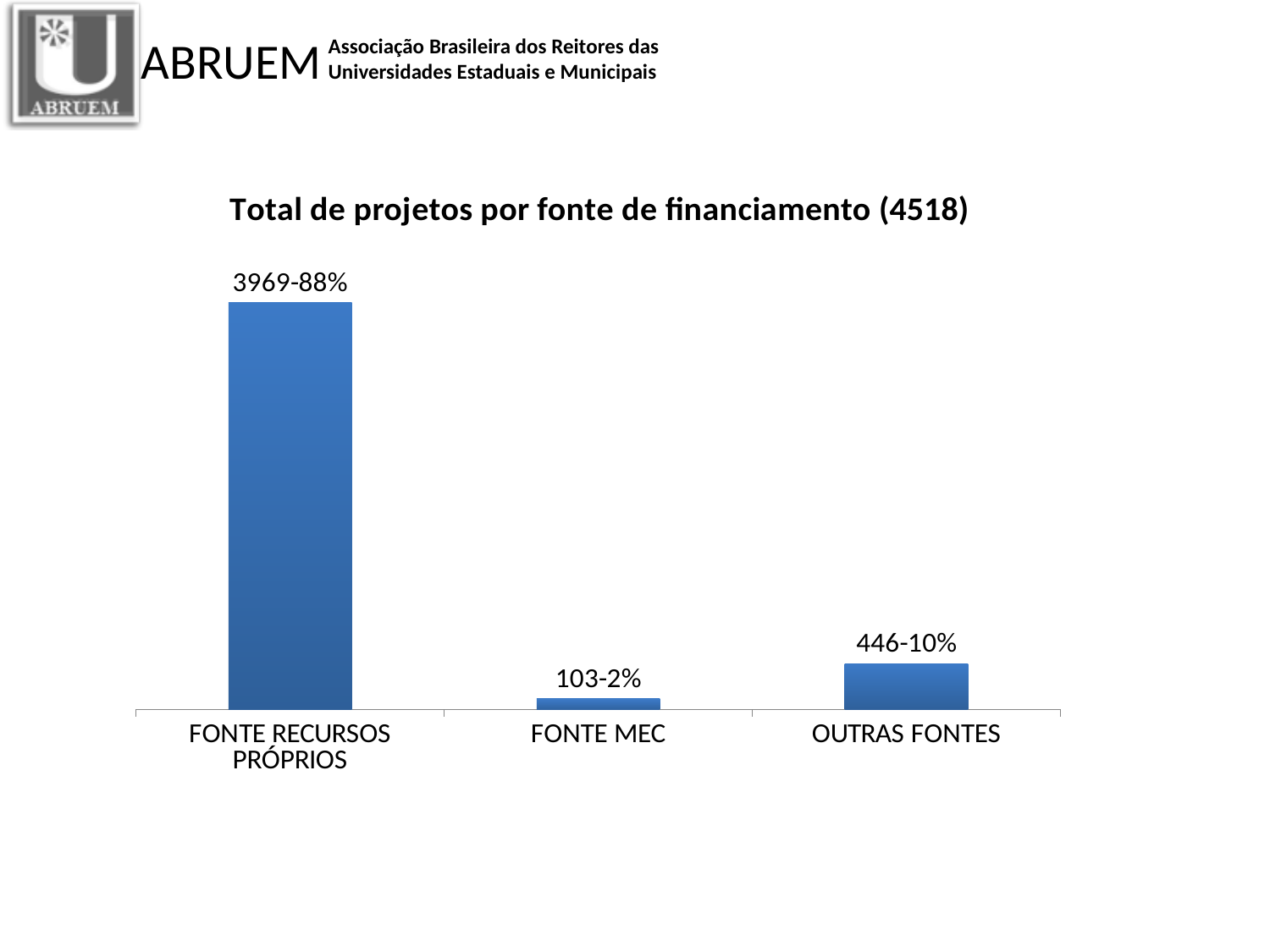
What is the difference in the number of projects between FONTE RECURSOS PRÓPRIOS and OUTRAS FONTES? 3523 What is the difference in the number of projects between OUTRAS FONTES and FONTE MEC? 343 What is the data label shown for FONTE RECURSOS PRÓPRIOS? 3969-88% How many categories are shown on the x axis? 3 Which funding source has the lowest number of projects? FONTE MEC What percentage of projects comes from FONTE RECURSOS PRÓPRIOS? 88% What is the title of the chart? Total de projetos por fonte de financiamento (4518) What is the data label shown for FONTE MEC? 103-2% Which funding source has the highest number of projects? FONTE RECURSOS PRÓPRIOS What kind of chart is shown on the slide? Bar chart Which has more projects, FONTE MEC or OUTRAS FONTES? OUTRAS FONTES What is the data label shown for OUTRAS FONTES? 446-10%